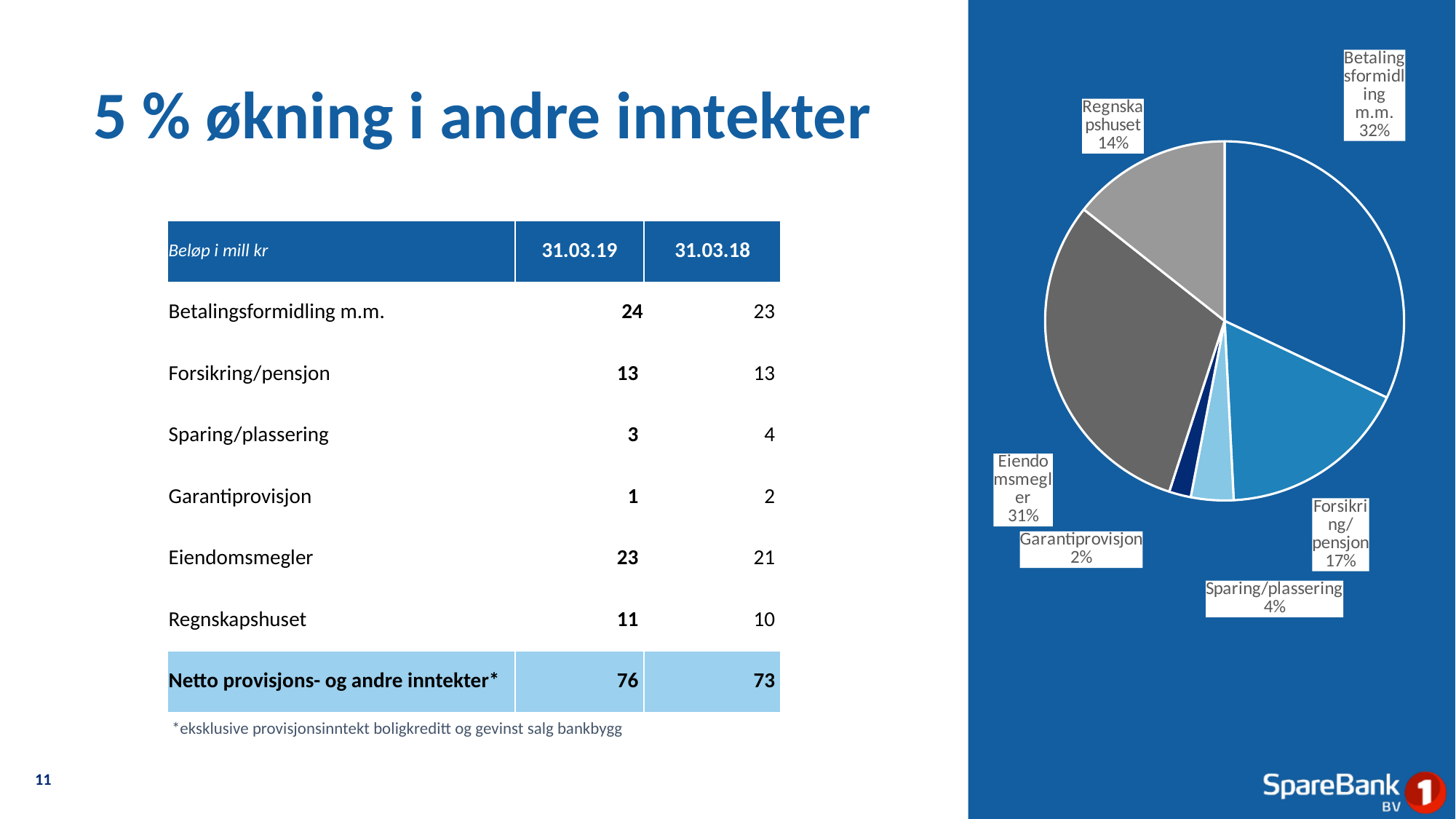
In the pie chart, what is the difference in percentage points between Sparing/plassering and Garantiprovisjon? 2 In the pie chart, what share does Sparing/plassering have? 4% In the pie chart, what share does Regnskapshuset have? 14% In the pie chart, what is the difference in percentage points between Eiendomsmegler and Regnskapshuset? 17 In the pie chart, what share does Betalingsformidling m.m. have? 32% Which slice of the pie chart is the smallest? Garantiprovisjon How many slices does the pie chart have? 6 Which slice of the pie chart is the largest? Betalingsformidling m.m. What kind of chart is shown on the right side of the slide? pie chart In the pie chart, which is larger: Forsikring/pensjon or Regnskapshuset? Forsikring/pensjon